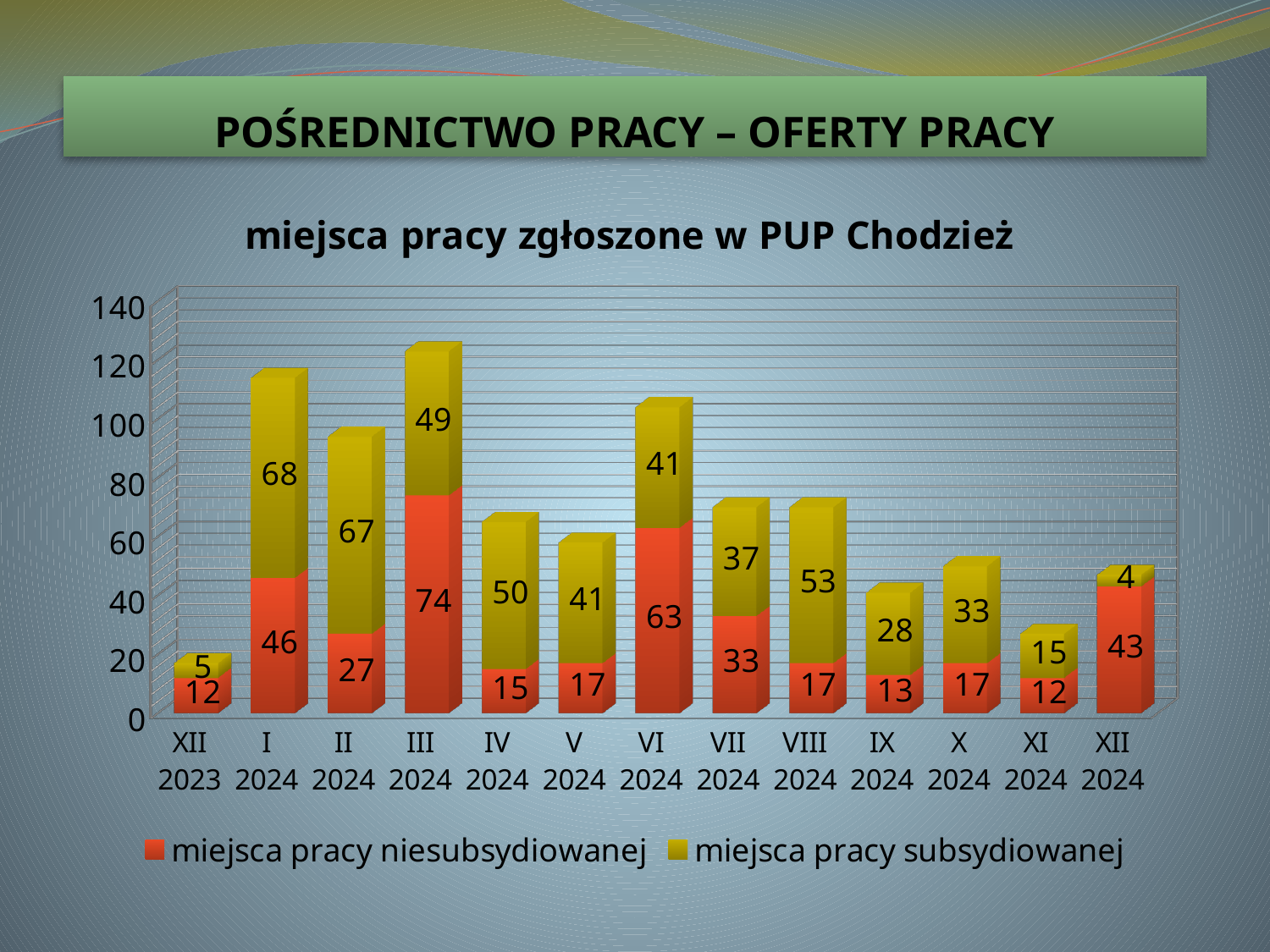
Which month has the highest value for 'miejsca pracy niesubsydiowanej'? III 2024 What is the difference between 'miejsca pracy subsydiowanej' in VIII 2024 and VII 2024? 16 What is the value for 'miejsca pracy subsydiowanej' in XII 2024? 4 What is the total of the stacked bar for III 2024? 123 Which is larger: 'miejsca pracy niesubsydiowanej' in VI 2024 or in VII 2024? VI 2024 What kind of chart is shown on the slide? Stacked bar chart How many months are shown on the x axis? 13 What is the value for 'miejsca pracy niesubsydiowanej' in III 2024? 74 What is the value for 'miejsca pracy subsydiowanej' in I 2024? 68 Which month has the lowest value for 'miejsca pracy subsydiowanej'? XII 2024 How many series does the legend list? 2 What is the total of the stacked bar for I 2024? 114